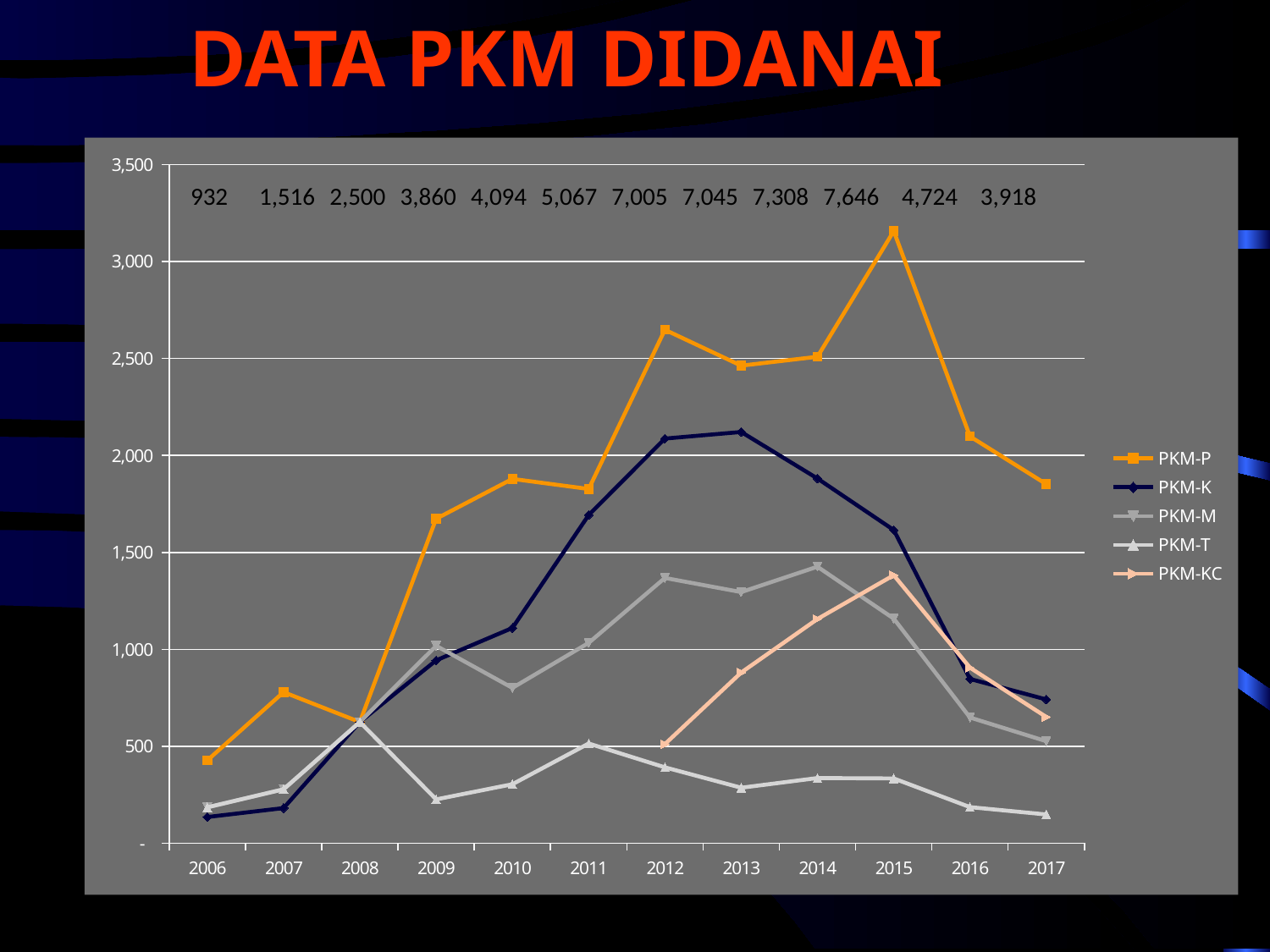
How many years are shown along the x axis? 12 Is the value for PKM-K in 2013 greater or less than 2,000? greater What number is printed above the chart for 2015? 7,646 In which year does the PKM-P line reach its highest value? 2015 What kind of chart is shown on the slide? line chart Which series has the lowest value in 2017? PKM-T In 2015, which is larger, PKM-P or PKM-K? PKM-P Does the PKM-P line rise or fall from 2015 to 2017? fall How many series does the legend list? 5 Is the value for PKM-T in 2017 greater or less than 500? less Is the value for PKM-P in 2015 greater or less than 3,000? greater What is the title of the slide? DATA PKM DIDANAI